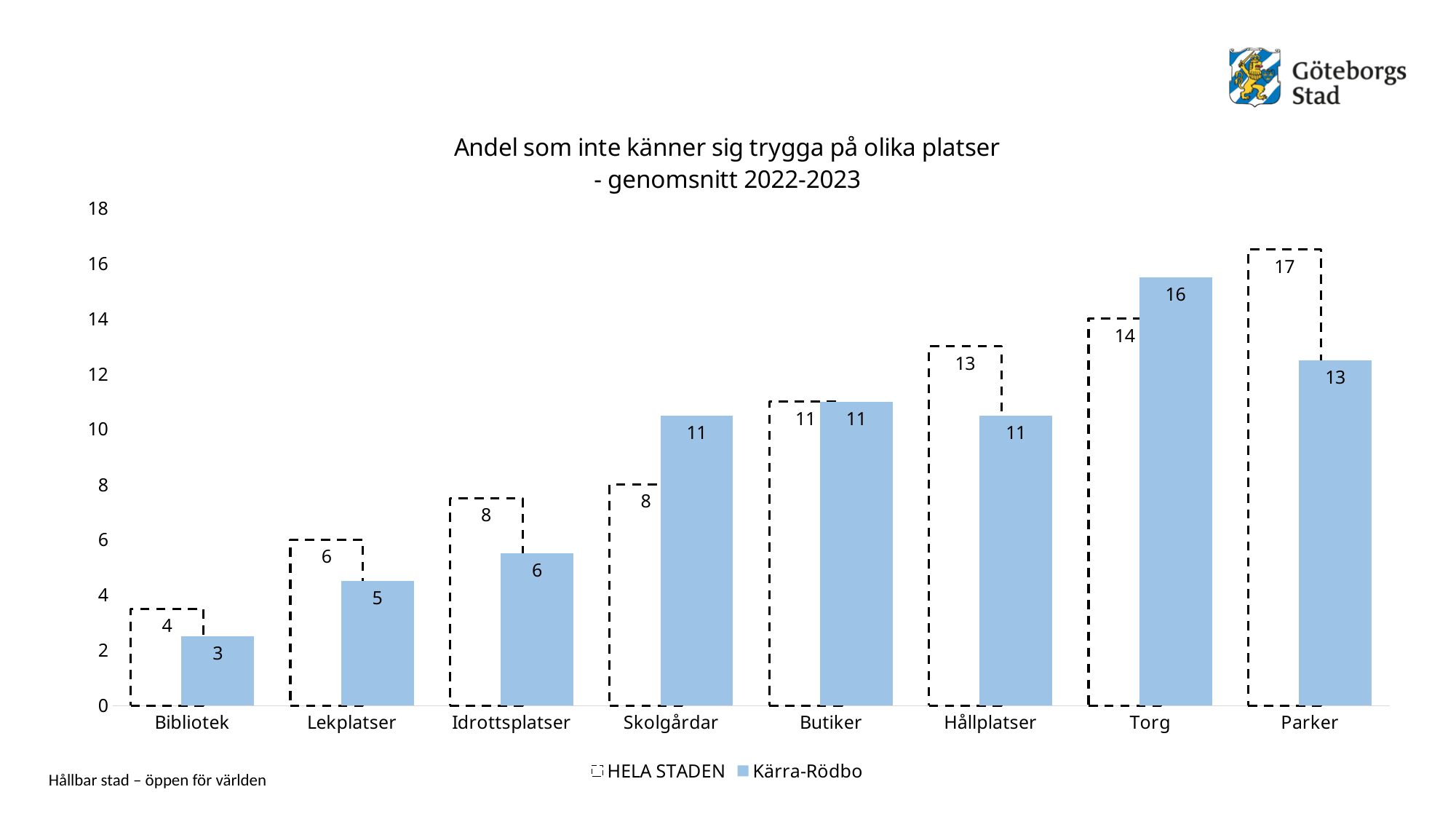
Which category has the lowest value for HELA STADEN? Bibliotek What is the value for Kärra-Rödbo at Torg? 16 What is the difference between HELA STADEN and Kärra-Rödbo at Parker? 4 What is the value for HELA STADEN at Parker? 17 How many series does the legend list? 2 Which is larger at Skolgårdar, the HELA STADEN value or the Kärra-Rödbo value? Kärra-Rödbo What kind of chart is shown on the slide? Bar chart How many categories are shown on the x axis? 8 What is the value for Kärra-Rödbo at Bibliotek? 3 What is the title of the chart? Andel som inte känner sig trygga på olika platser - genomsnitt 2022-2023 Which category has the highest value for Kärra-Rödbo? Torg What is the value for HELA STADEN at Hållplatser? 13